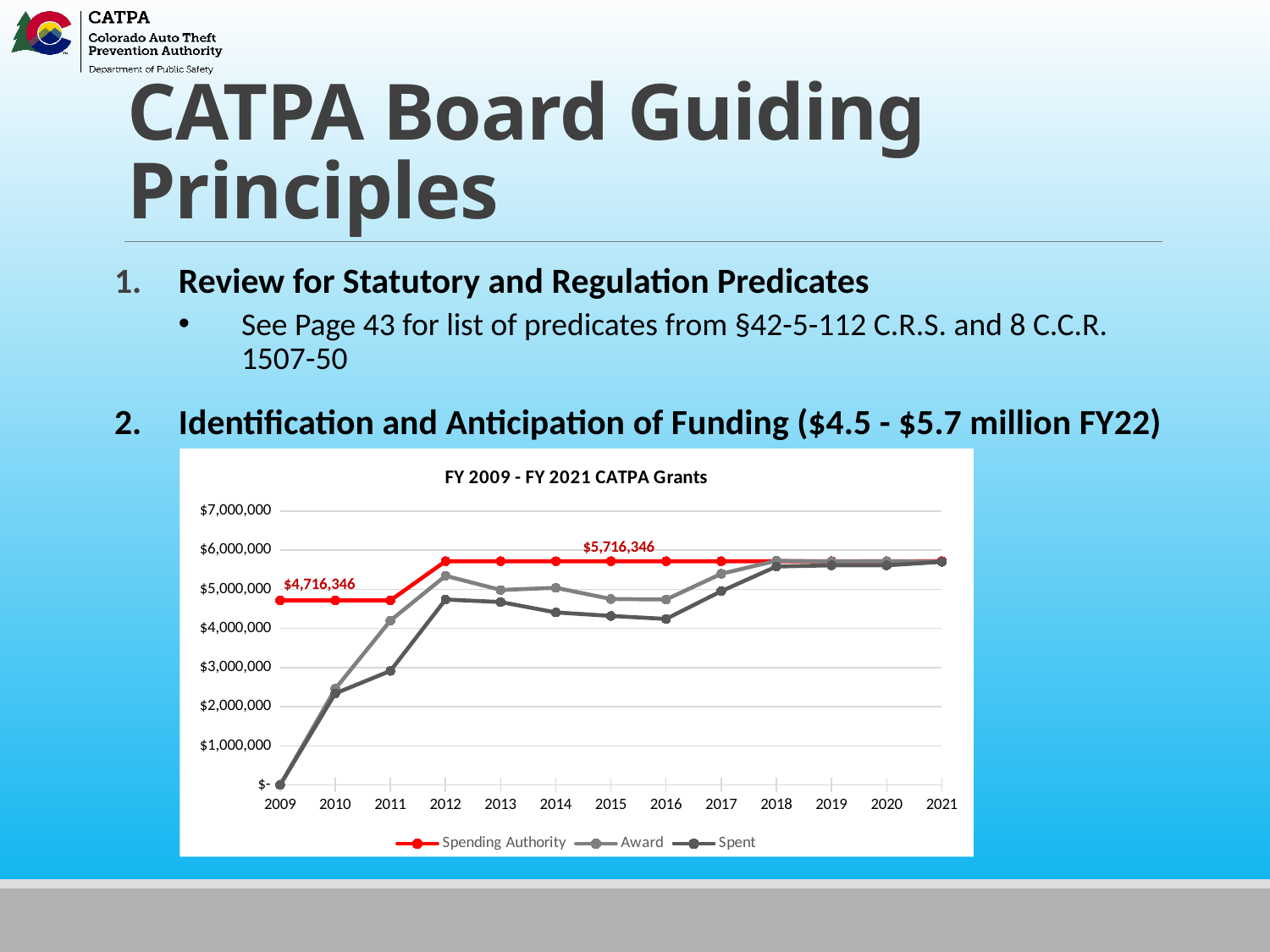
Is the Award value for 2016 greater or less than $5,000,000? less In 2012, which is larger, the Award value or the Spent value? Award What is the difference between the two labelled Spending Authority values, $5,716,346 and $4,716,346? $1,000,000 Is the Award value for 2010 greater or less than $3,000,000? less What kind of chart is shown on the slide? Line chart Is the Spent value for 2012 greater or less than $4,000,000? greater How many series does the chart's legend list? 3 What is the Spending Authority value for 2009? $4,716,346 Does the Spent series rise or fall from 2009 to 2012? Rise How many years are plotted along the x axis of the chart? 13 What is the title of the chart? FY 2009 - FY 2021 CATPA Grants What is the Spending Authority value for 2015? $5,716,346